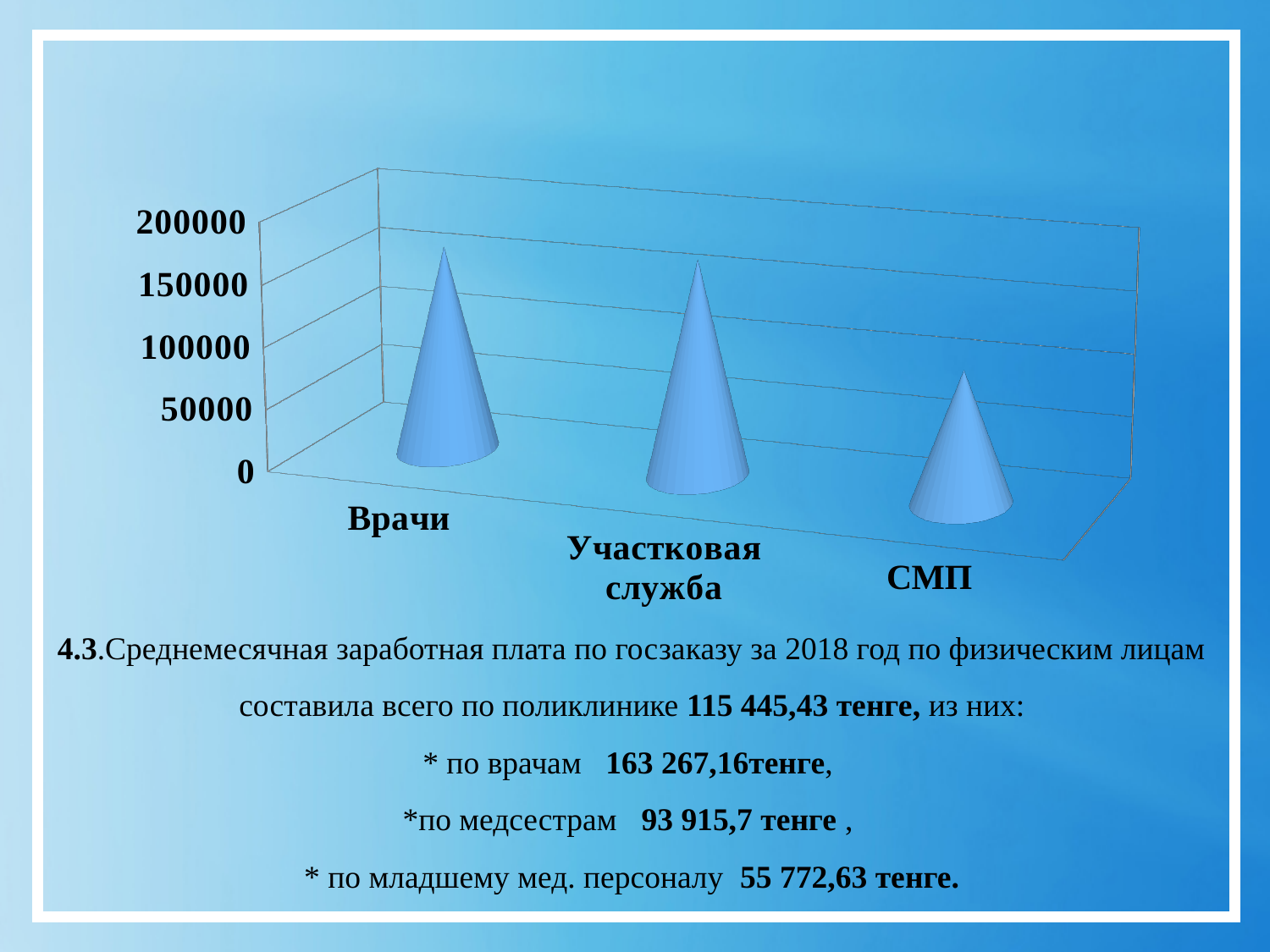
Which is larger, the value for Врачи or the value for СМП? Врачи What is the highest value shown on the vertical axis of the chart? 200000 Which category has the lowest value on the chart? СМП Is the value for Участковая служба greater or less than 100000? greater What kind of chart is shown on the slide? bar chart Which is larger, the value for Участковая служба or the value for СМП? Участковая служба How many categories are plotted on the chart? 3 What is the label of the first category on the x axis? Врачи Is the value for СМП greater or less than 150000? less Is the value for Врачи greater or less than 100000? greater